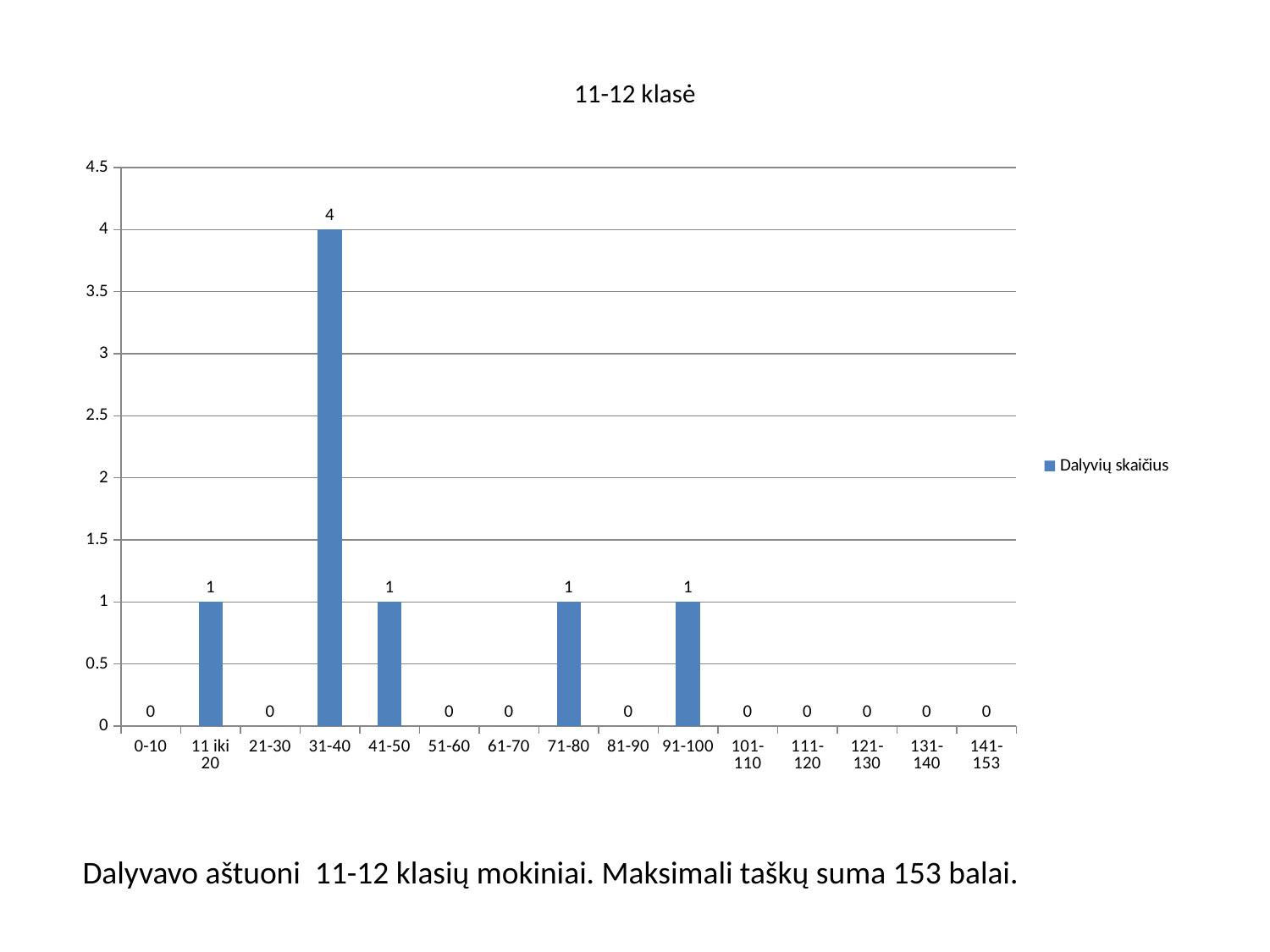
How many categories are shown on the x axis? 15 What kind of chart is shown? bar chart How many series does the legend list? 1 What is the value for the 91-100 category? 1 What is the difference between the values for 31-40 and 41-50? 3 What is the name of the series in the legend? Dalyvių skaičius What is the title of the chart? 11-12 klasė Which category has the highest value? 31-40 What is the value for the 51-60 category? 0 What is the value for the 31-40 category? 4 Which is larger, the value for 71-80 or the value for 81-90? 71-80 Is the value for 31-40 greater or less than 3? greater